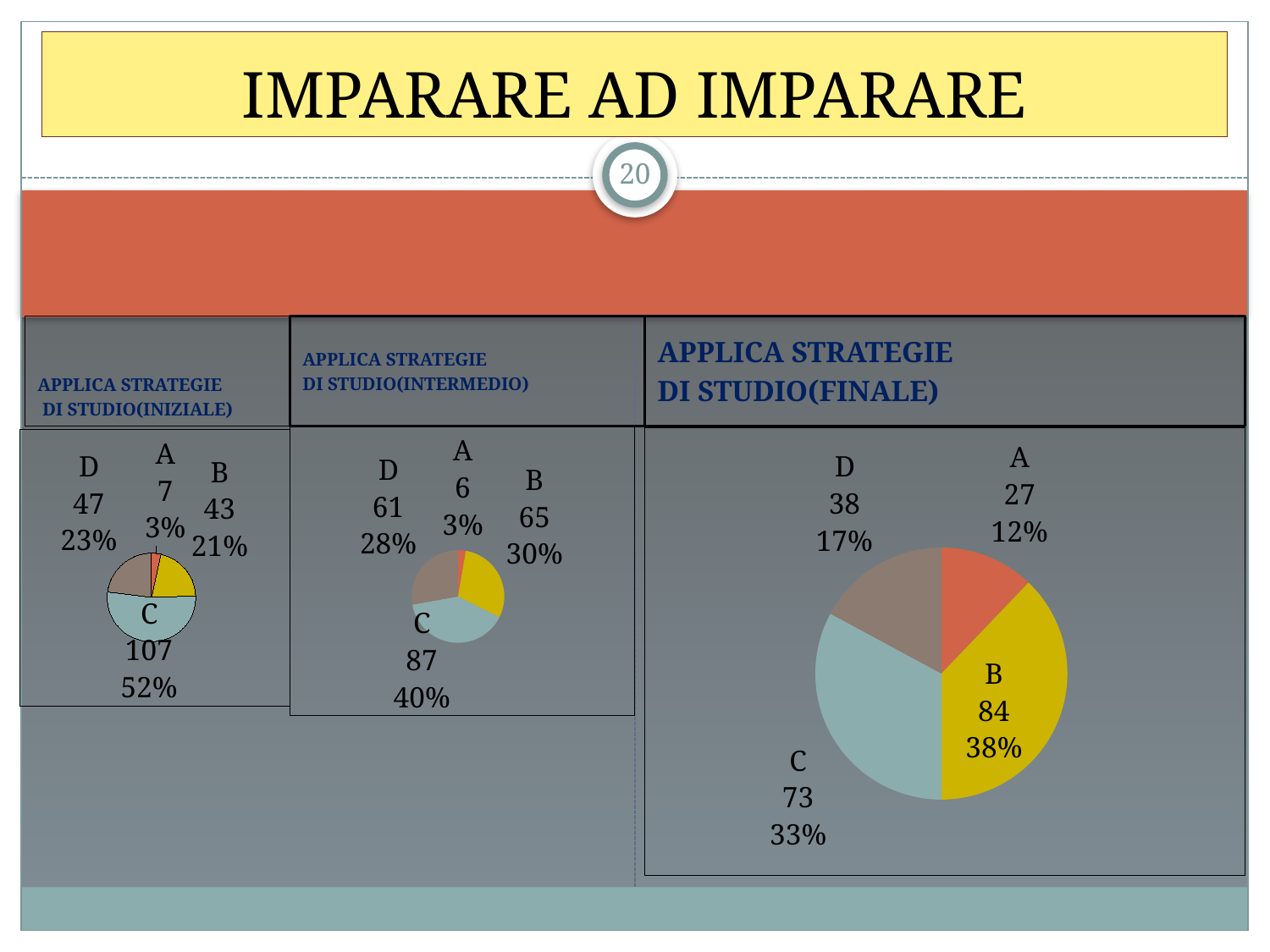
In the APPLICA STRATEGIE DI STUDIO(FINALE) chart, which is larger, the value for B or the value for C? B How many charts are shown on the slide? 3 In the APPLICA STRATEGIE DI STUDIO(INTERMEDIO) chart, what is the value for B? 65 In the APPLICA STRATEGIE DI STUDIO(INIZIALE) chart, what share of the pie does D represent? 23% In the APPLICA STRATEGIE DI STUDIO(FINALE) chart, what is the value for A? 27 In the APPLICA STRATEGIE DI STUDIO(INTERMEDIO) chart, which category has the largest value? C In the APPLICA STRATEGIE DI STUDIO(INIZIALE) chart, what is the value for C? 107 In the APPLICA STRATEGIE DI STUDIO(FINALE) chart, what share of the pie does B represent? 38% In the APPLICA STRATEGIE DI STUDIO(INTERMEDIO) chart, what is the difference between the values for C and D? 26 What kind of chart is used in the APPLICA STRATEGIE DI STUDIO(FINALE) panel? Pie chart In the APPLICA STRATEGIE DI STUDIO(FINALE) chart, how many categories are shown? 4 In the APPLICA STRATEGIE DI STUDIO(INIZIALE) chart, which category has the smallest value? A